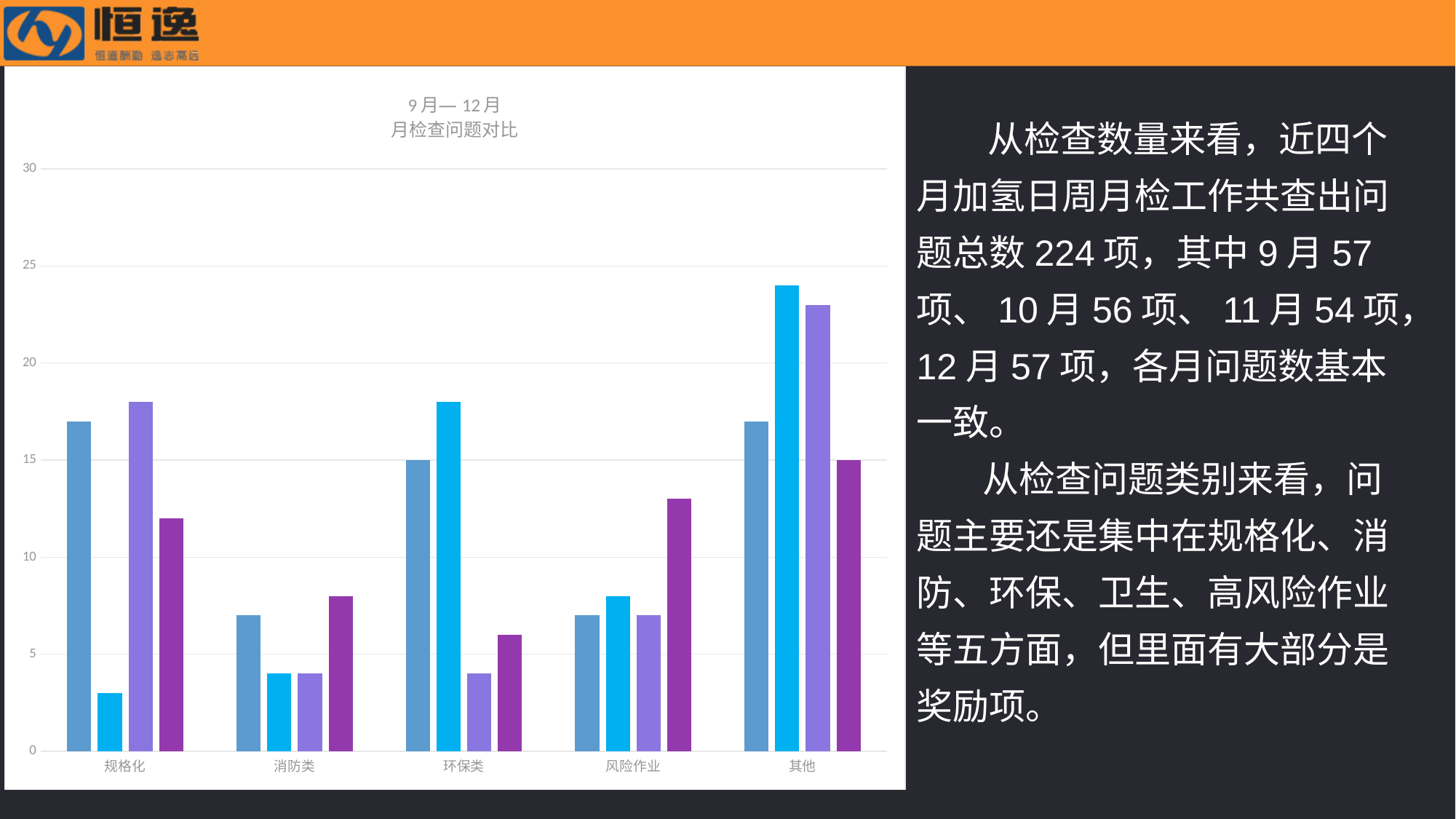
What is the title of the chart? 9月—12月 月检查问题对比 Which category has the lowest bars overall in the chart? 消防类 Is the value of the dark purple bar for 风险作业 greater or less than 10? greater How many bars are plotted for each category? 4 Which category contains the tallest bar in the chart? 其他 Is the value of the steel-blue (first) bar for 消防类 greater or less than 10? less How many categories are shown on the x axis of the chart? 5 Is the value of the light purple (third) bar for 其他 greater or less than 20? greater What kind of chart is shown on the slide? bar chart For 环保类, which is taller: the steel-blue (first) bar or the cyan (second) bar? the cyan bar